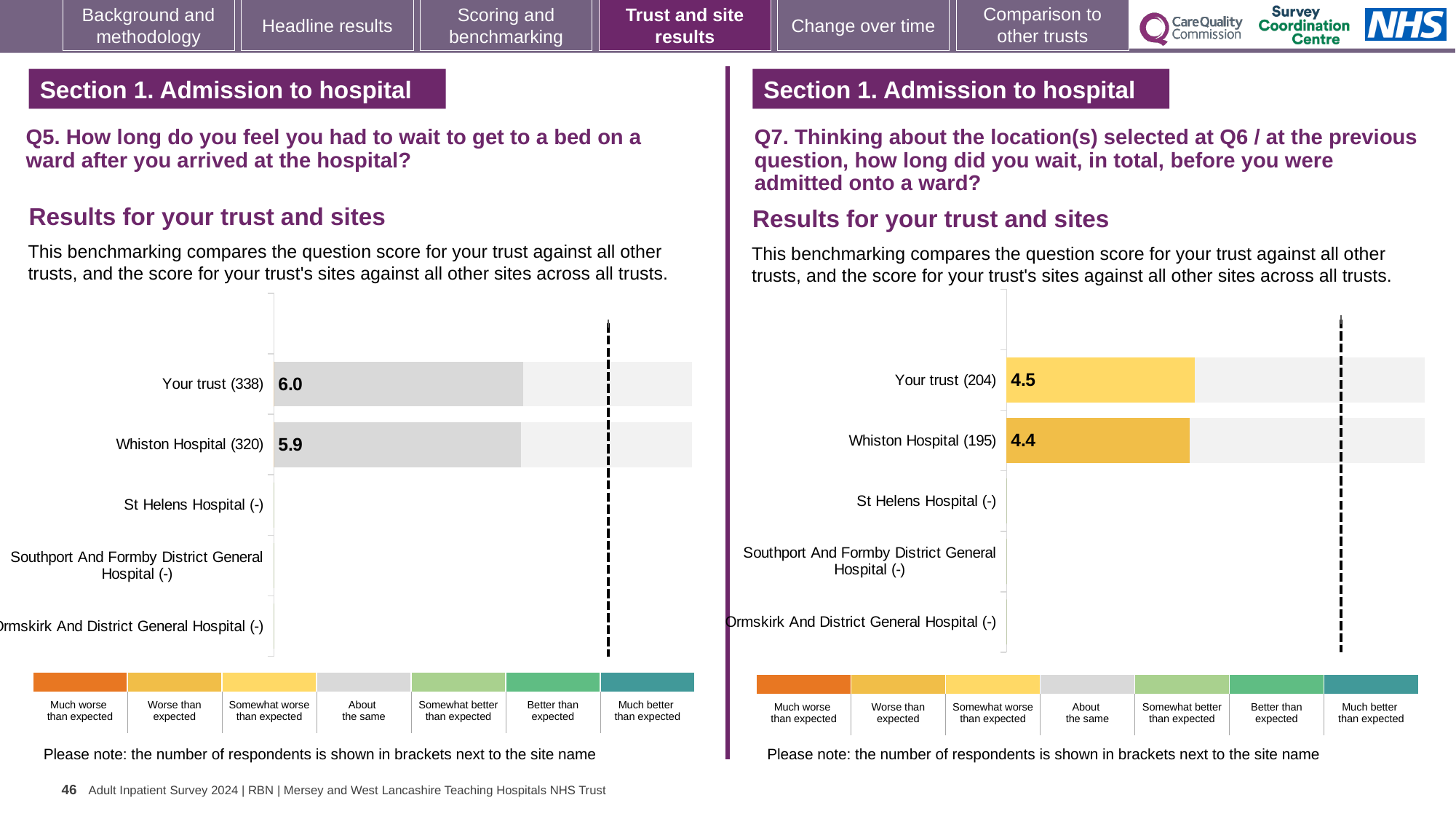
In the Q5 chart on the left, which has the higher score, Your trust or Whiston Hospital? Your trust In the Q7 chart on the right, what is the score for Your trust (204)? 4.5 In the Q5 chart on the left, what is the difference between the score for Your trust and the score for Whiston Hospital? 0.1 In the Q5 chart on the left, what is the score for Your trust (338)? 6.0 How many site or trust categories are listed on the vertical axis of the Q5 chart on the left? 5 In the Q5 chart on the left, what is the score for Whiston Hospital (320)? 5.9 In the Q7 chart on the right, what is the difference between the score for Your trust and the score for Whiston Hospital? 0.1 In the Q7 chart on the right, which benchmark category does the colour of the Whiston Hospital bar correspond to in the legend? Worse than expected In the Q5 chart on the left, which benchmark category does the colour of the Your trust bar correspond to in the legend? About the same What kind of chart is the Q7 chart on the right? Bar chart In the Q7 chart on the right, which has the higher score, Your trust or Whiston Hospital? Your trust In the Q7 chart on the right, what is the score for Whiston Hospital (195)? 4.4